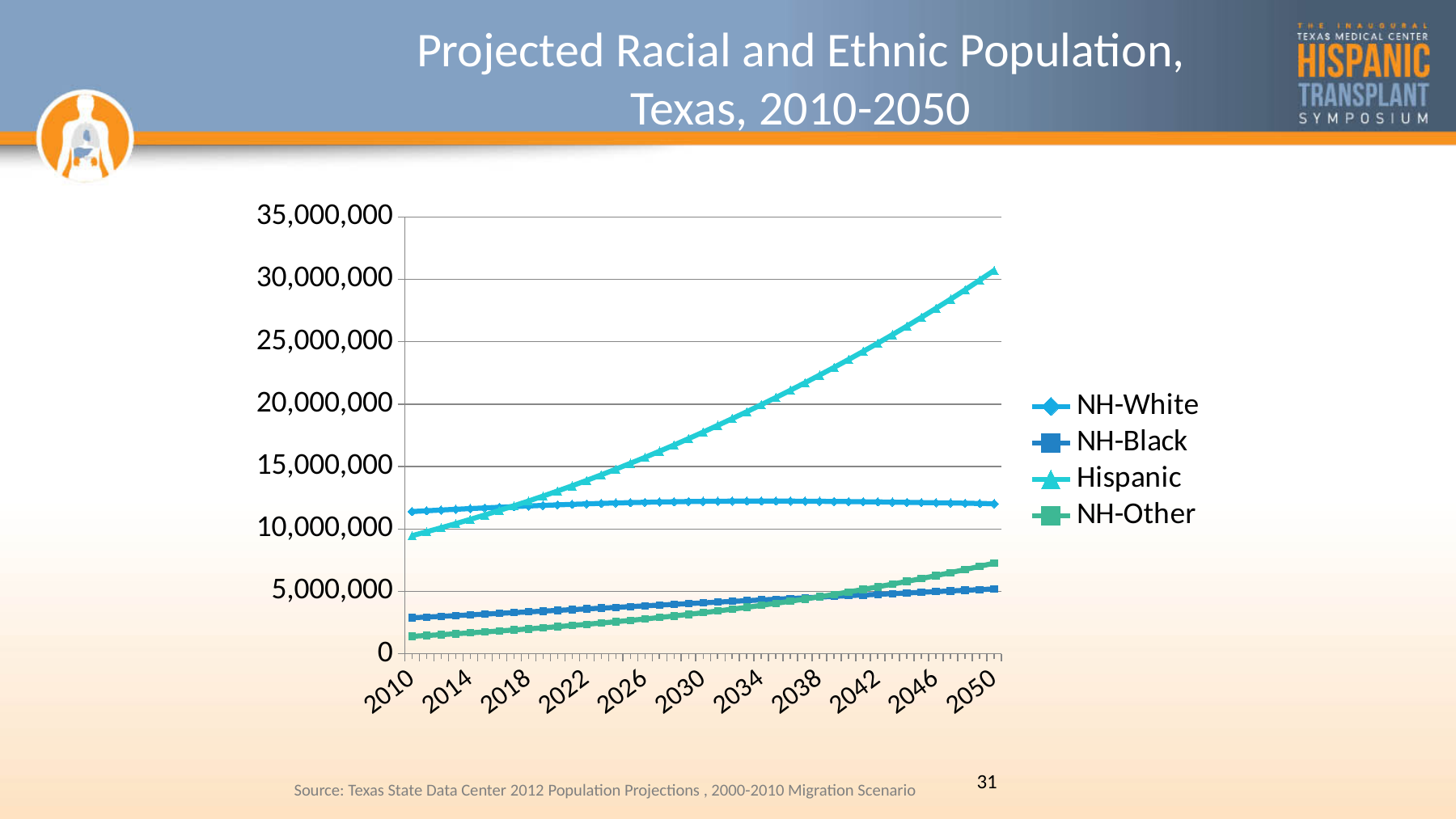
How many series does the chart legend list? 4 What is the title of the chart on the slide? Projected Racial and Ethnic Population, Texas, 2010-2050 Does the NH-Other series rise or fall from 2010 to 2050? rise In 2010, which is larger: NH-White or Hispanic? NH-White Is the value for NH-White in 2010 greater or less than 10,000,000? greater Which series has the lowest value in 2010? NH-Other Is the value for NH-Black in 2050 greater or less than 10,000,000? less Is the value for Hispanic in 2050 greater or less than 25,000,000? greater In 2050, which is larger: NH-Other or NH-Black? NH-Other Which series has the highest value in 2050? Hispanic What kind of chart is shown on the slide? line chart Does the Hispanic series rise or fall from 2010 to 2050? rise